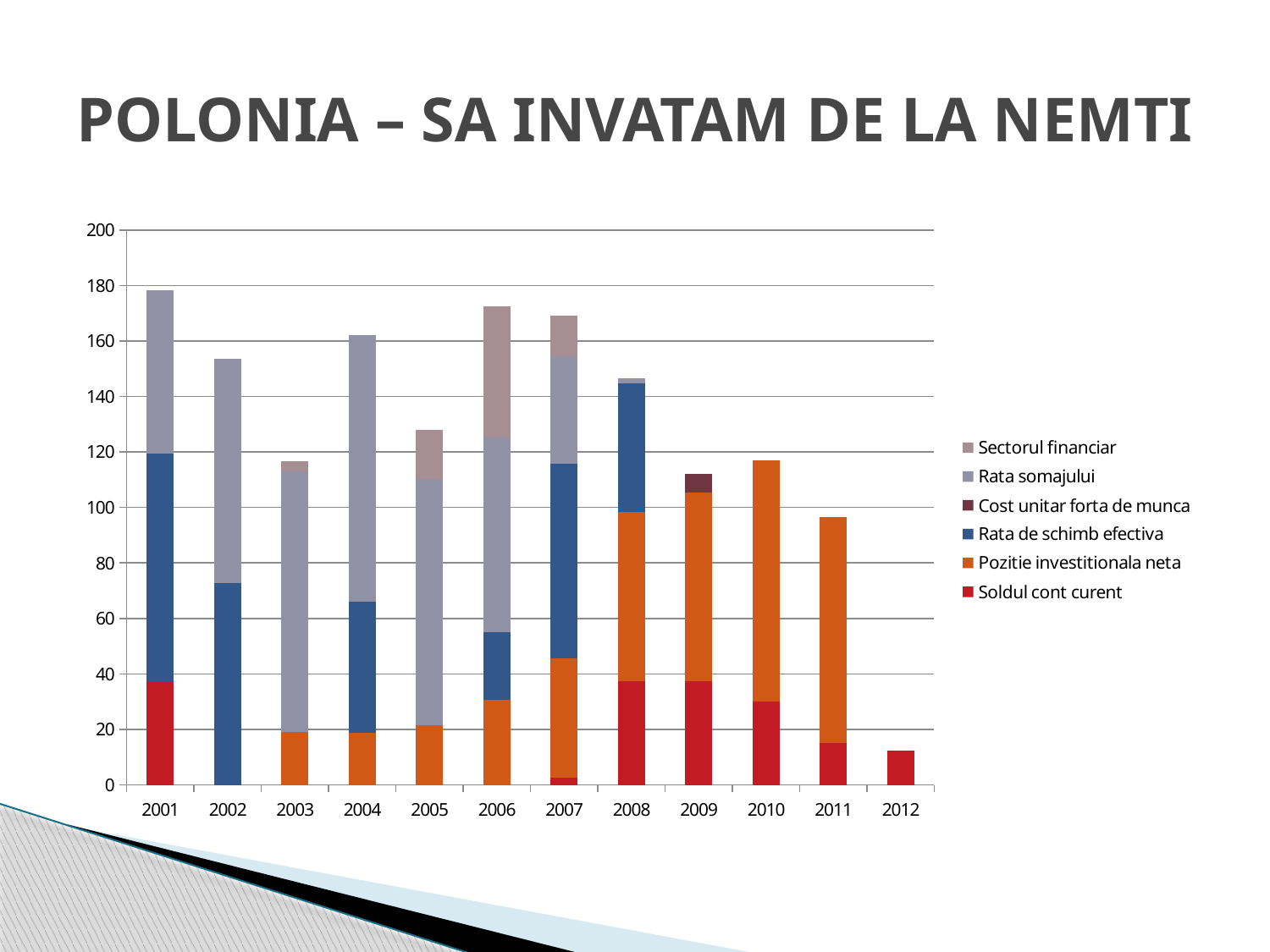
Which stacked bar is taller, 2004 or 2005? 2004 Which year has the tallest stacked bar? 2001 Is the total of the stacked bar for 2010 greater or less than 100? greater Which series is shown in red in the chart's legend? Soldul cont curent What kind of chart is shown on the slide? stacked bar chart How many years are shown on the x axis of the chart? 12 Which year has the shortest stacked bar? 2012 Is the total of the stacked bar for 2001 greater or less than 160? greater Is the total of the stacked bar for 2012 greater or less than 20? less Which stacked bar is taller, 2001 or 2002? 2001 How many series does the chart's legend list? 6